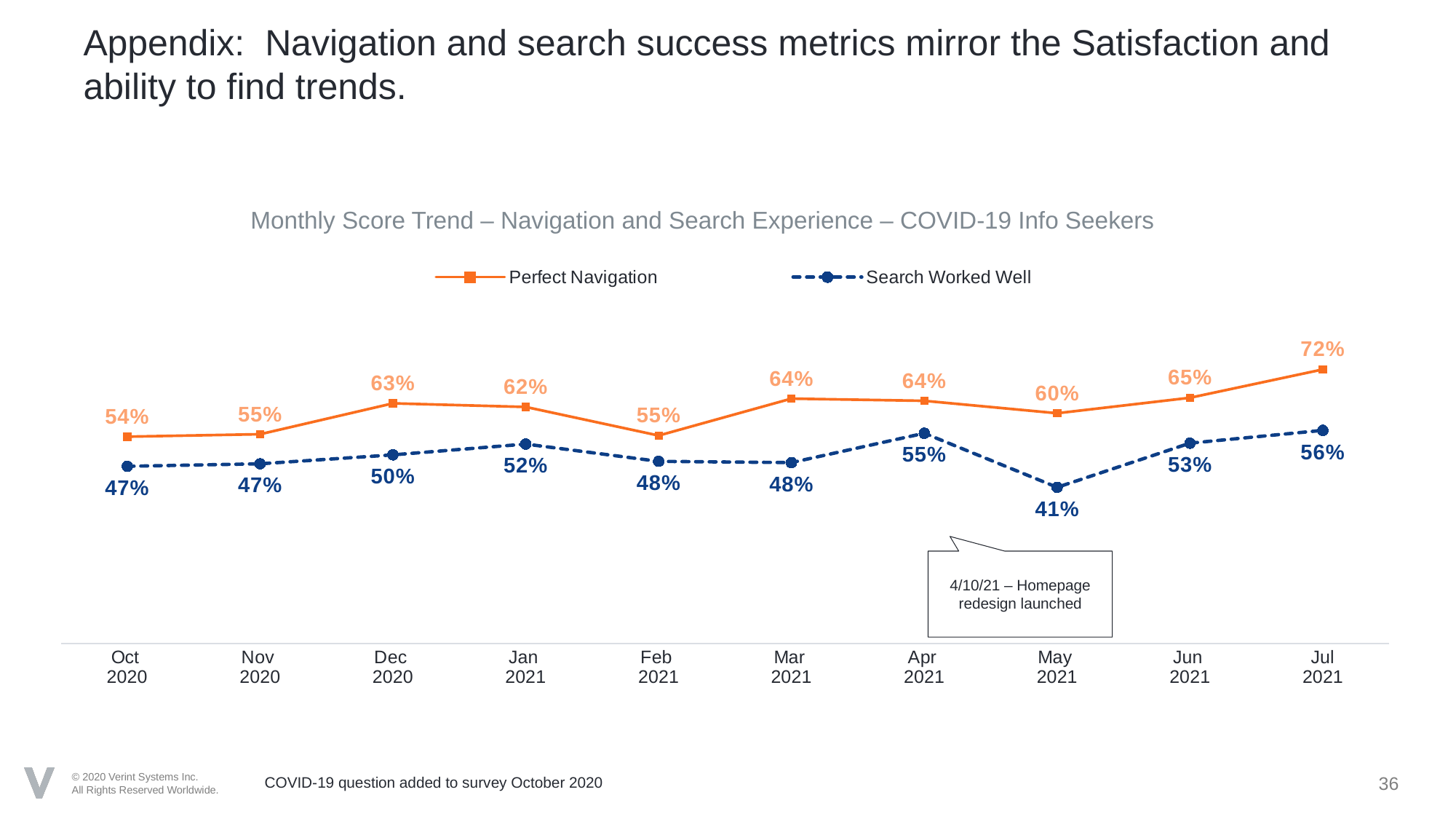
What is the Search Worked Well value for May 2021? 41% What is the Perfect Navigation value for Feb 2021? 55% What is the Perfect Navigation value for Jul 2021? 72% How many series does the legend list? 2 What event does the callout box on the chart describe? 4/10/21 – Homepage redesign launched What is the Search Worked Well value for Jan 2021? 52% Which month has the lowest Search Worked Well value? May 2021 How many months are plotted on the x axis? 10 Which is larger: Search Worked Well in Apr 2021 or Search Worked Well in Jun 2021? Apr 2021 Which month has the highest Perfect Navigation value? Jul 2021 What kind of chart is shown on the slide? Line chart What is the difference between Perfect Navigation and Search Worked Well in May 2021? 19%